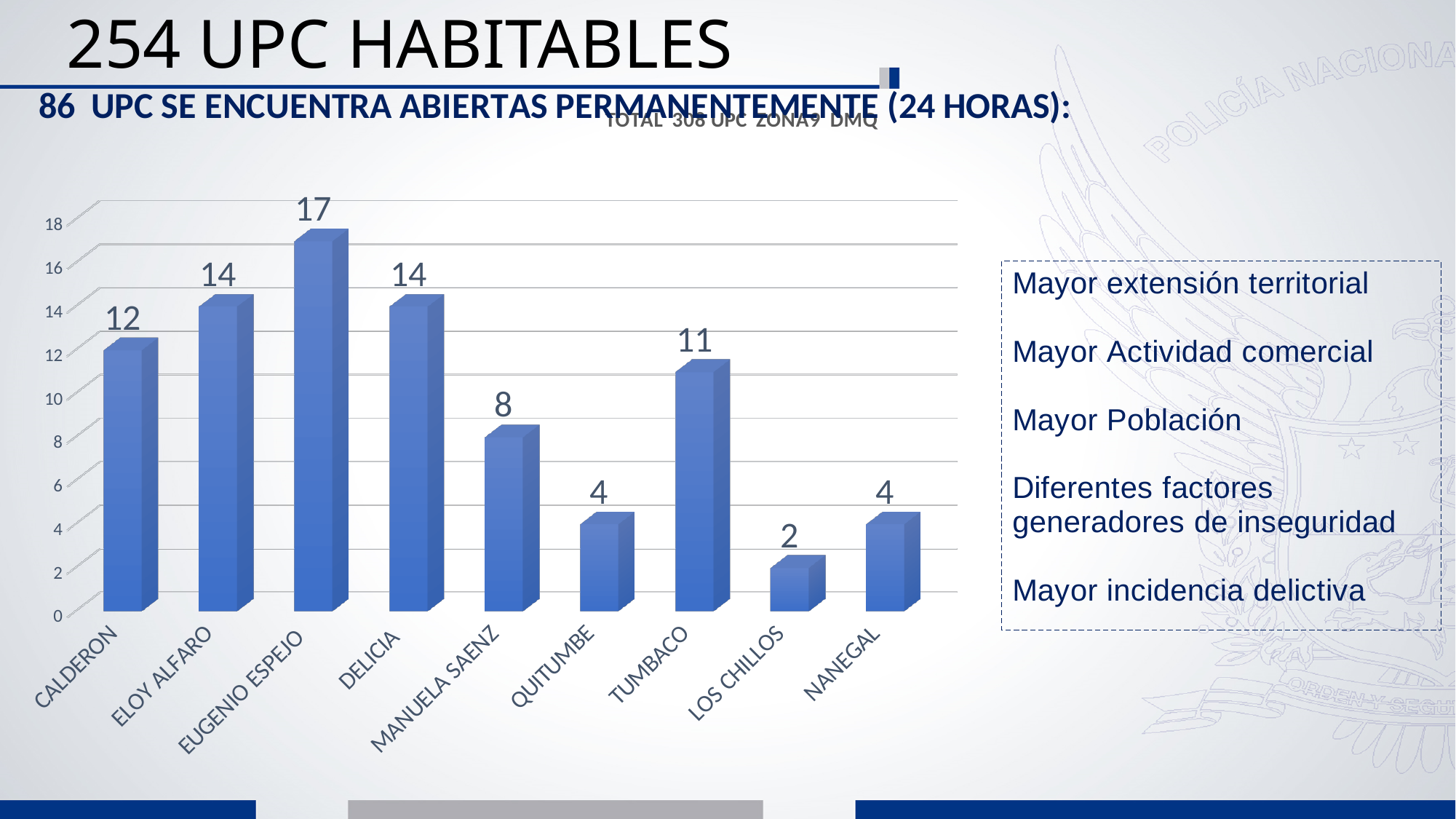
What is the difference between the values for EUGENIO ESPEJO and CALDERON? 5 Which category has the lowest value? LOS CHILLOS What is the value for EUGENIO ESPEJO? 17 What is the value for TUMBACO? 11 Which is larger, the value for CALDERON or the value for MANUELA SAENZ? CALDERON What is the value for MANUELA SAENZ? 8 Which category has the highest value? EUGENIO ESPEJO Do the values for ELOY ALFARO and DELICIA match? Yes, both are 14 How many categories are shown on the x axis? 9 What is the difference between the values for TUMBACO and QUITUMBE? 7 What kind of chart is shown on the slide? Bar chart What is the value for LOS CHILLOS? 2